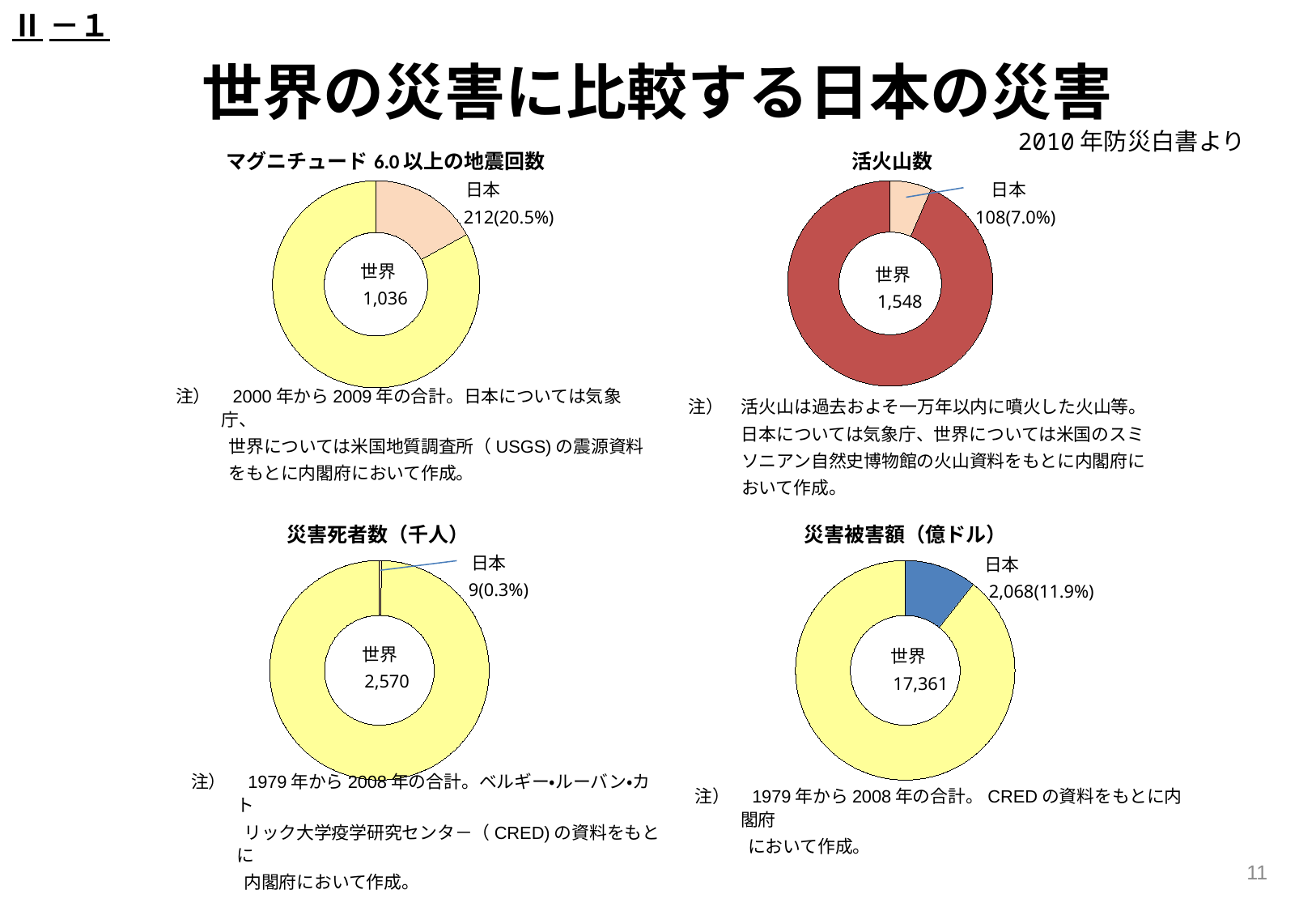
In the 活火山数 chart, what value is shown for 世界? 1,548 In the マグニチュード6.0以上の地震回数 chart, what value is shown for 日本? 212(20.5%) In the 活火山数 chart, what value is shown for 日本? 108(7.0%) What kind of chart is the 災害被害額（億ドル） chart? Donut (pie) chart In the 災害死者数（千人） chart, what value is shown for 世界? 2,570 In the マグニチュード6.0以上の地震回数 chart, how much larger is the 世界 value than the 日本 value? 824 In the 災害死者数（千人） chart, what share of the total does 日本 account for? 0.3% In the マグニチュード6.0以上の地震回数 chart, what value is shown for 世界? 1,036 How many charts are shown on the slide? 4 In the 活火山数 chart, what share of the total does 日本 account for? 7.0% In the 災害被害額（億ドル） chart, what value is shown for 世界? 17,361 In the 災害被害額（億ドル） chart, what value is shown for 日本? 2,068(11.9%)